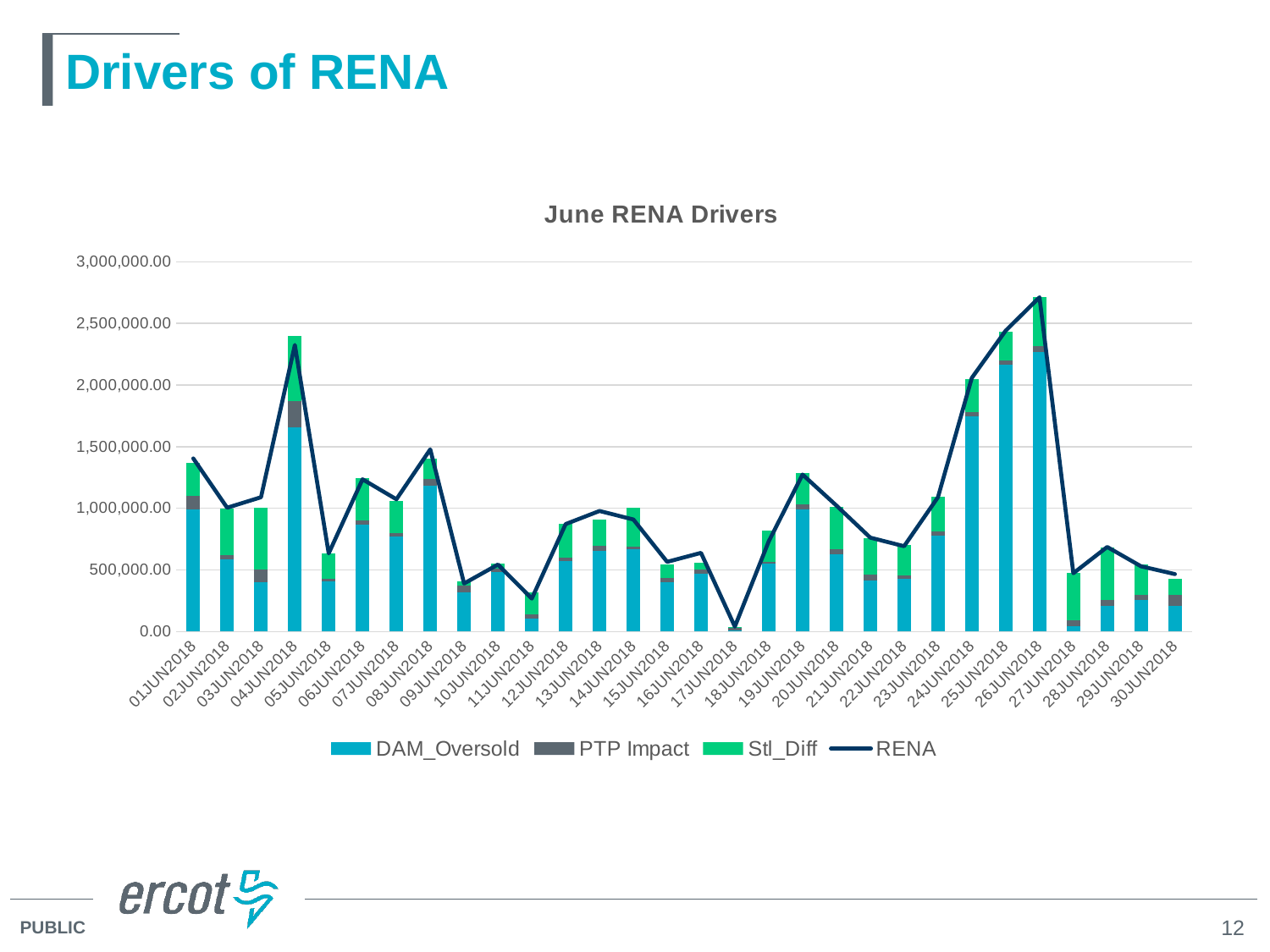
Does the RENA line rise or fall from 24JUN2018 to 26JUN2018? rise Which date has the lowest RENA value? 17JUN2018 Is the RENA value for 26JUN2018 greater or less than 2,500,000.00? greater Is the RENA value for 11JUN2018 greater or less than 500,000.00? less Is the RENA value for 01JUN2018 greater or less than 1,000,000.00? greater How many series does the legend list? 4 How many dates are shown on the x axis? 30 What kind of chart is this? Stacked bar chart with a line Which date has the highest RENA value? 26JUN2018 Which date has the larger RENA value, 04JUN2018 or 08JUN2018? 04JUN2018 What is the title of the chart? June RENA Drivers